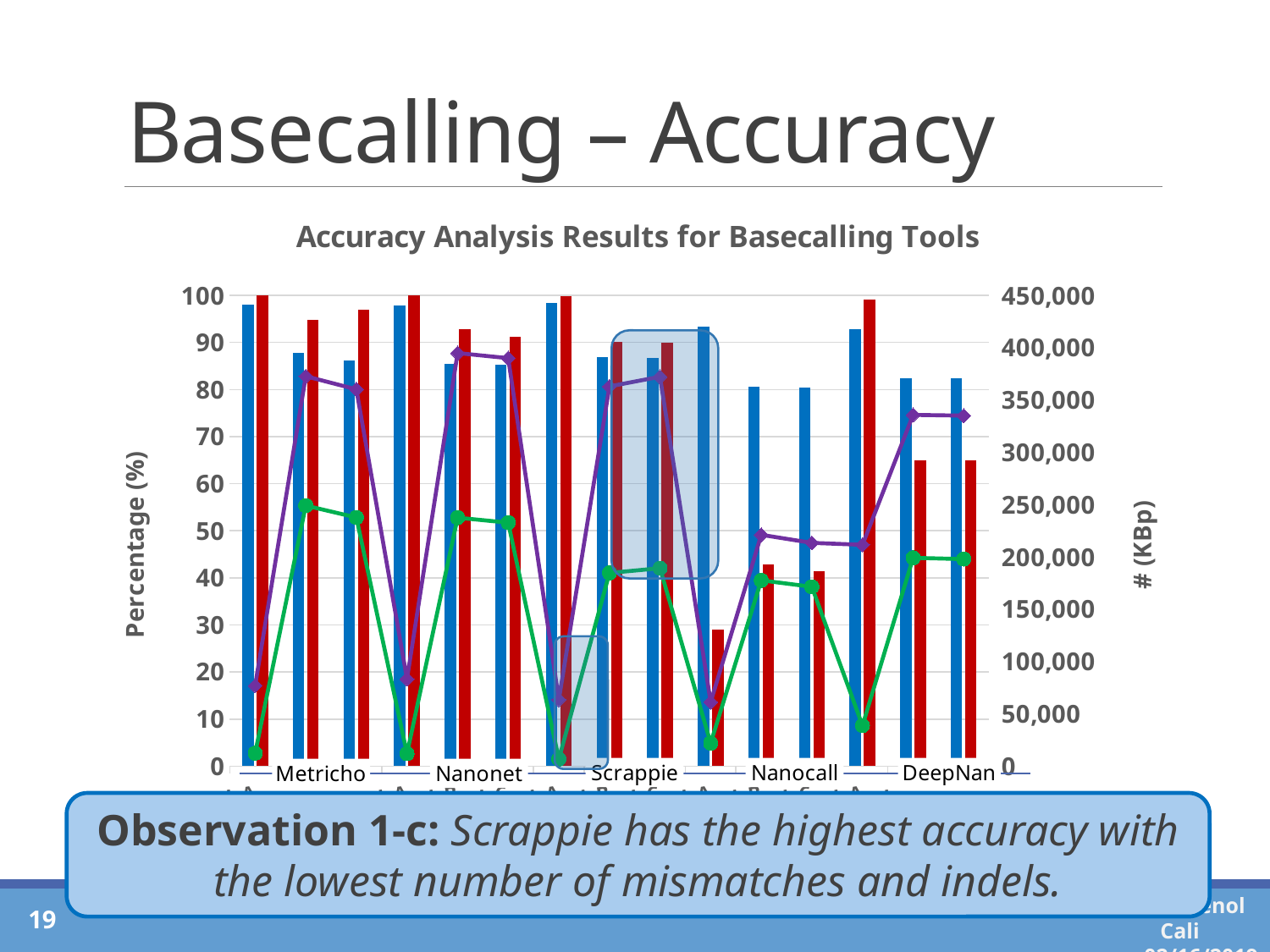
Is the shortest red bar in the Nanocall group greater or less than 40 on the Percentage (%) axis? less What kind of chart is shown on the slide? A combined bar and line chart Is the highest purple line point in the DeepNan group greater or less than 300,000 on the # (KBp) axis? greater What is the title of the right-hand vertical axis? # (KBp) How many basecalling tool groups are labelled along the x axis? 5 Is the lowest green line point in the Scrappie group greater or less than 50,000 on the # (KBp) axis? less What is the title of the chart? Accuracy Analysis Results for Basecalling Tools